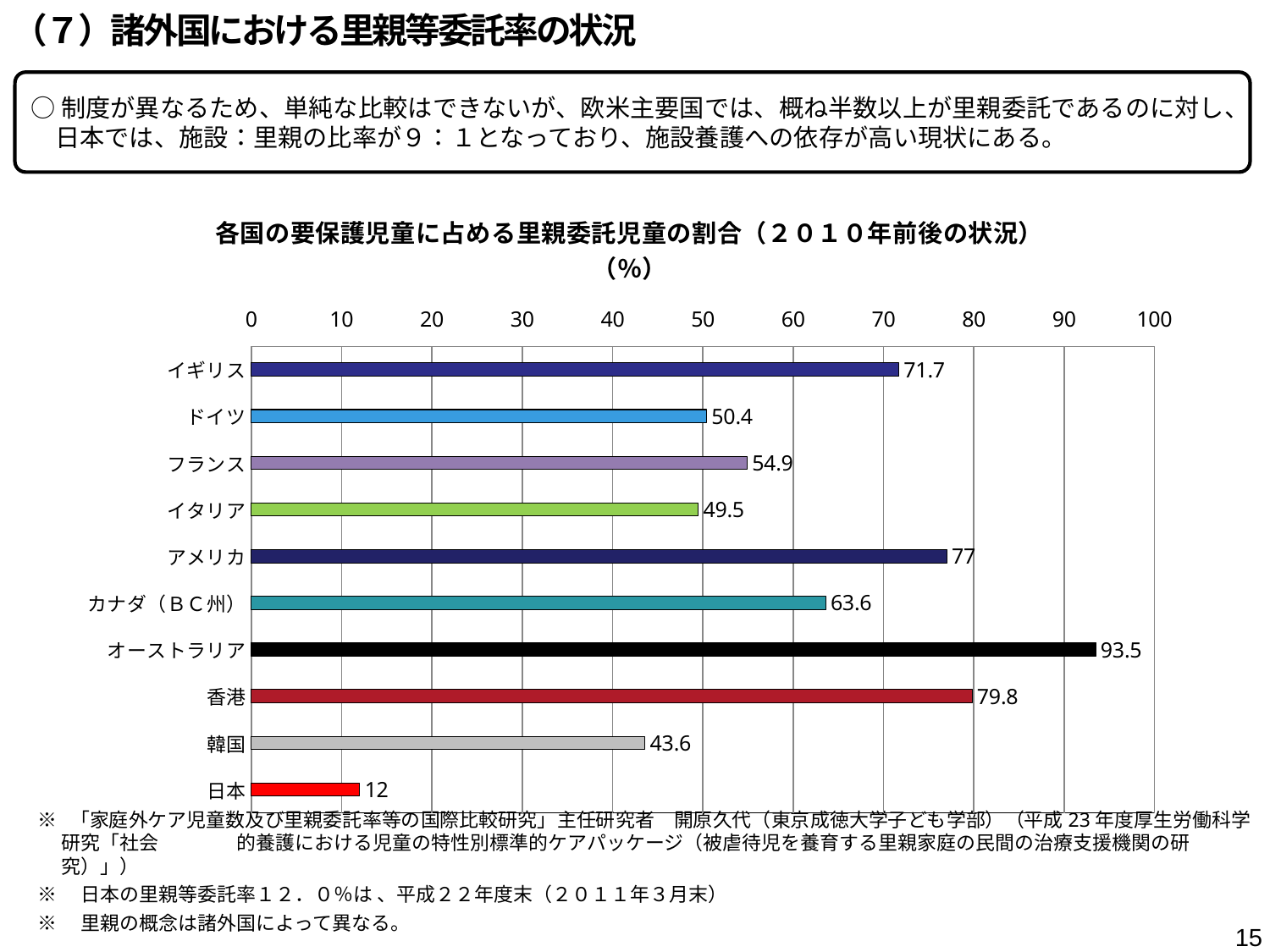
What is the difference between the values for アメリカ and ドイツ? 26.6 What kind of chart is shown on the slide? bar chart Which country has the lowest value? 日本 What is the value for 日本? 12 What is the value for カナダ（ＢＣ州）? 63.6 How many countries/regions are shown in the chart? 10 What is the title of the chart? 各国の要保護児童に占める里親委託児童の割合（２０１０年前後の状況）（%） Which is larger, the value for 香港 or the value for 韓国? 香港 What is the maximum value shown on the horizontal axis? 100 Which country has the highest value? オーストラリア Is the value for フランス greater or less than 50? greater What is the value for イギリス? 71.7